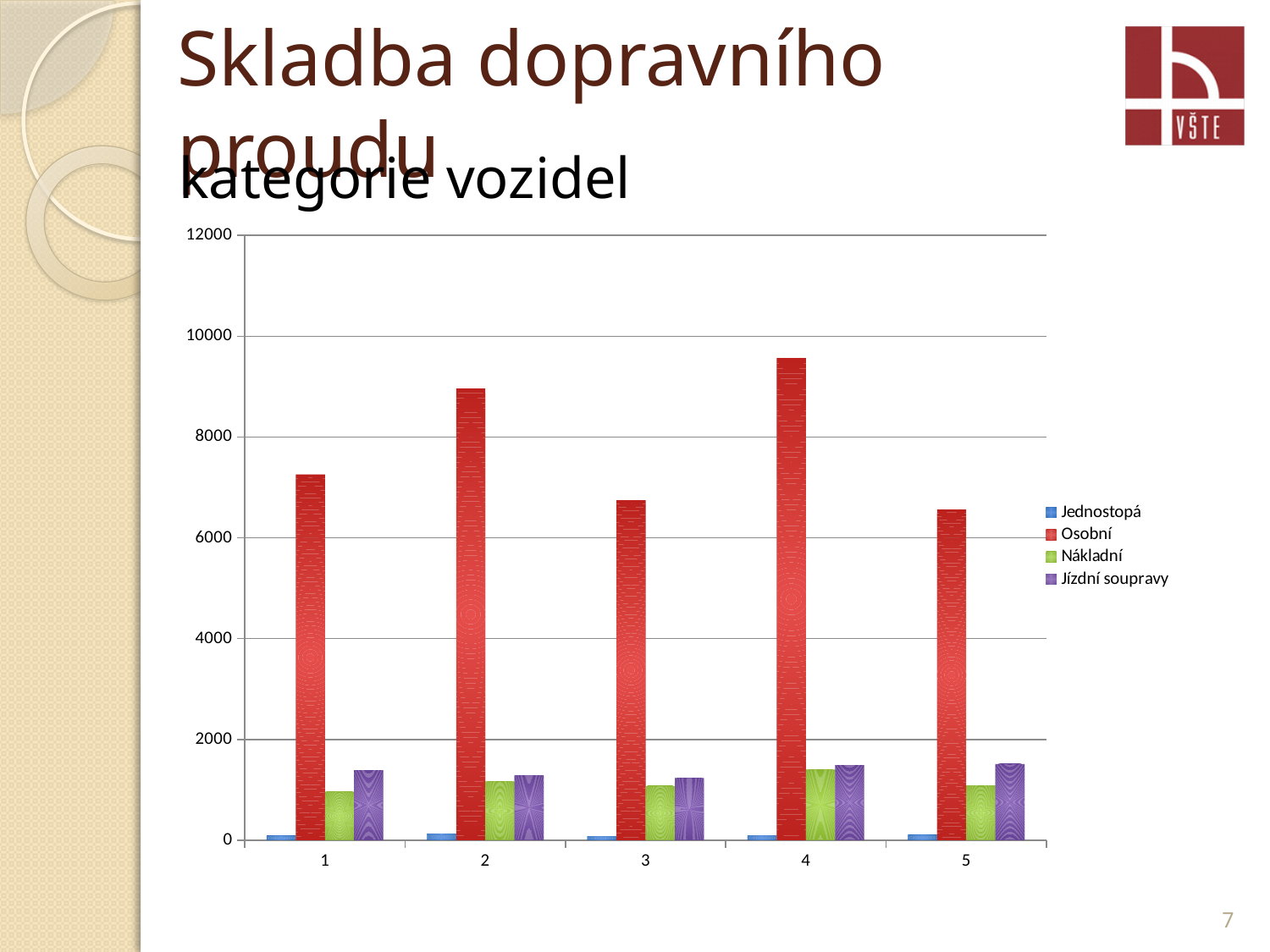
Which is larger, the Osobní value for category 2 or for category 3? category 2 Which series is shown in red in the chart? Osobní How many categories are shown on the x axis of the chart? 5 For which category is the Osobní value highest? 4 Which is larger, the Osobní value for category 4 or for category 1? category 4 What are the four series listed in the chart's legend? Jednostopá, Osobní, Nákladní, Jízdní soupravy Is the Osobní value for category 4 greater or less than 8000? greater What kind of chart is shown on the slide? bar chart Is the Nákladní value for category 1 greater or less than 2000? less How many series does the chart's legend list? 4 Is the Osobní value for category 1 greater or less than 8000? less